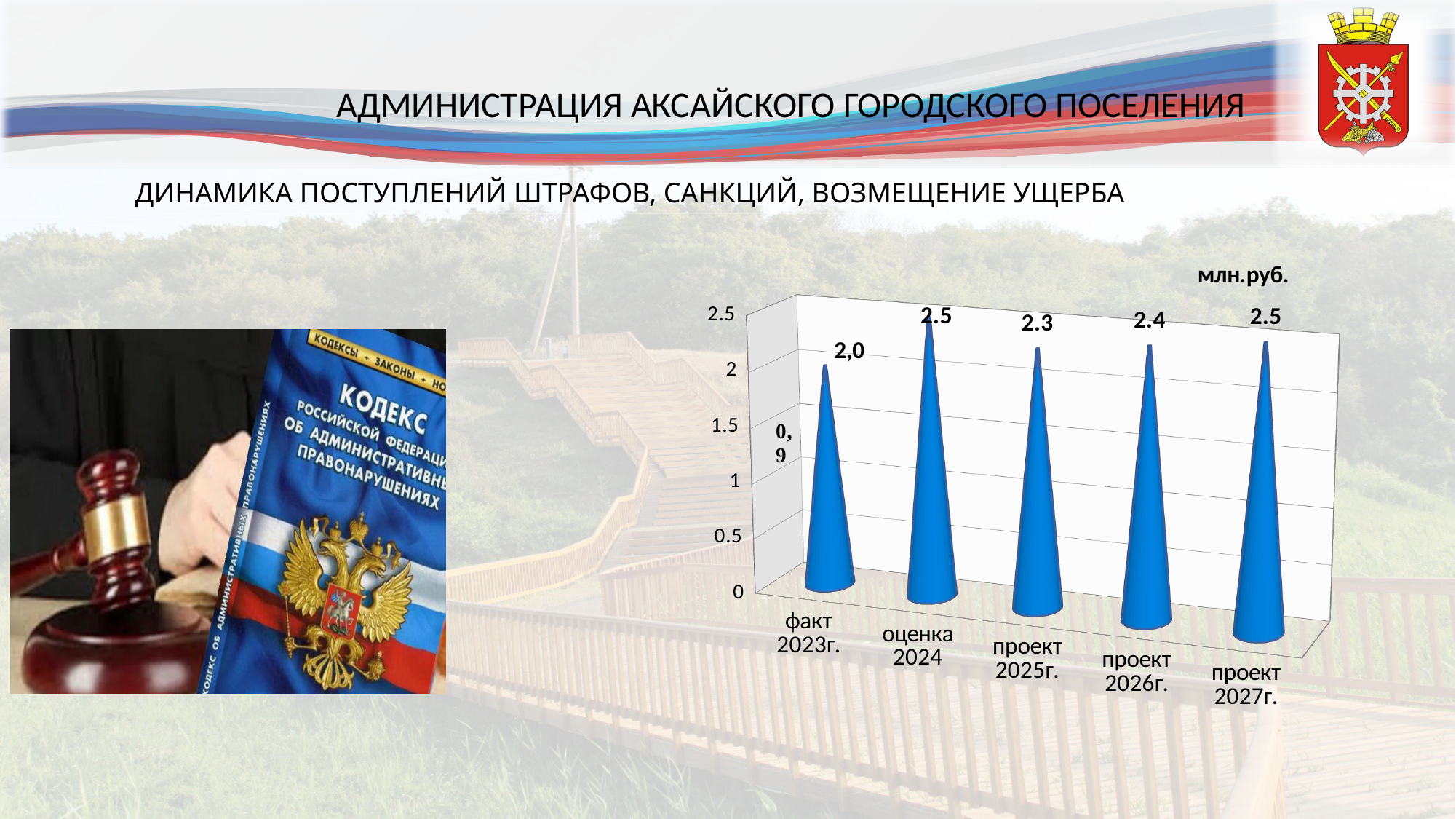
Which is larger, the value for проект 2026г. or проект 2025г.? проект 2026г. Which category has the lowest value? факт 2023г. What kind of chart is this? bar chart What is the value for факт 2023г.? 2,0 What is the value for оценка 2024? 2.5 What is the value for проект 2026г.? 2.4 What is the difference between the values for проект 2027г. and проект 2025г.? 0.2 What is the value for проект 2025г.? 2.3 How many categories are shown on the x axis? 5 Do the values rise or fall from проект 2025г. to проект 2027г.? rise What is the value for проект 2027г.? 2.5 What unit is shown above the chart? млн.руб.